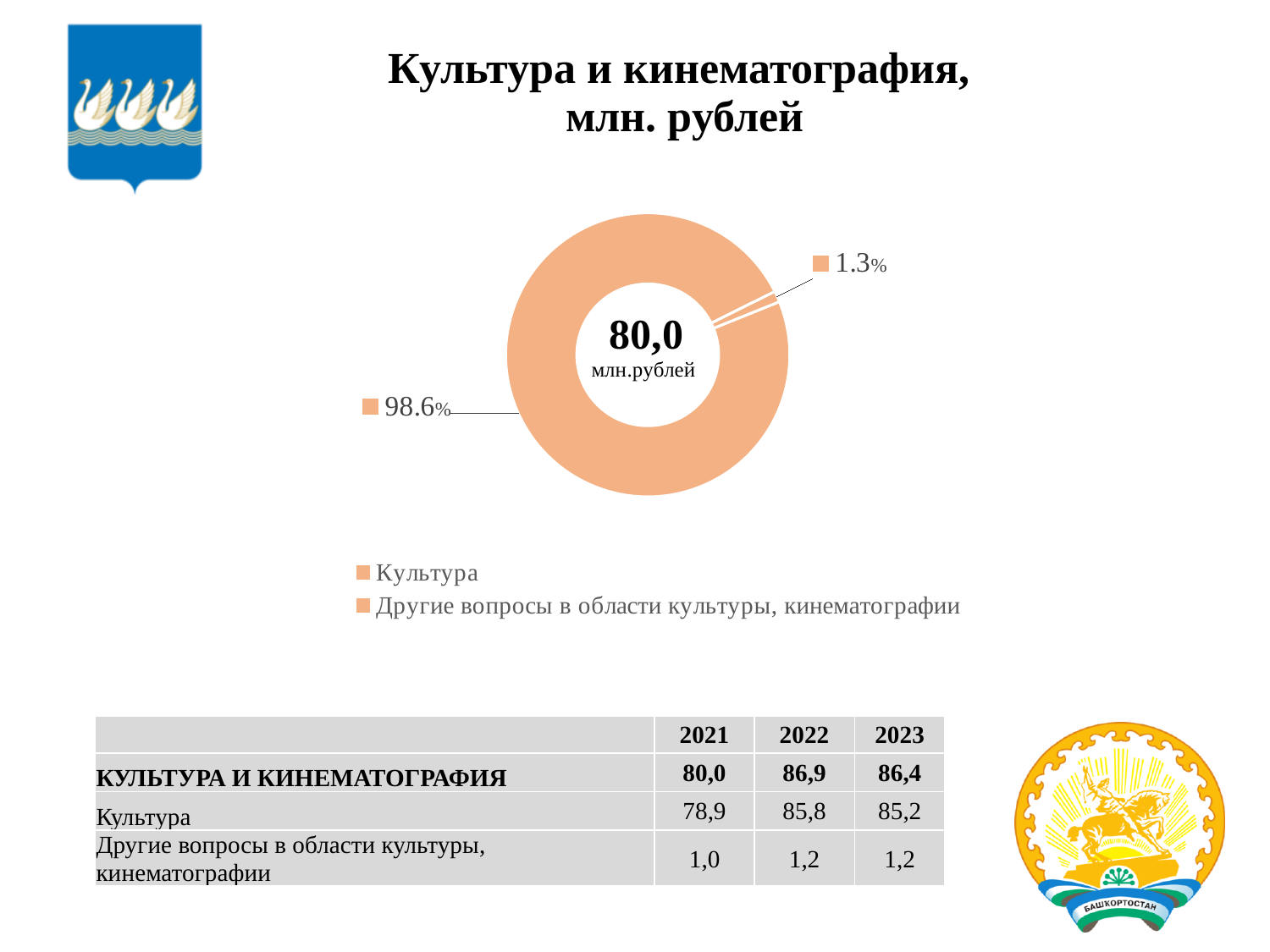
What is the title of the chart on the slide? Культура и кинематография, млн. рублей Is the share of 'Культура' in the doughnut chart greater or less than 50%? greater What total value is printed in the centre of the doughnut chart? 80,0 млн.рублей How many entries does the legend of the doughnut chart list? 2 Which slice of the doughnut chart is the largest? Культура What kind of chart is shown on the slide? Doughnut (pie) chart What percentage share does the 'Другие вопросы в области культуры, кинематографии' slice have in the doughnut chart? 1.3% Which slice of the doughnut chart is the smallest? Другие вопросы в области культуры, кинематографии What is the difference in percentage points between the two slices of the doughnut chart? 97.3 How many slices does the doughnut chart have? 2 What percentage share does the 'Культура' slice have in the doughnut chart? 98.6% Which is larger in the doughnut chart: the share of 'Культура' or the share of 'Другие вопросы в области культуры, кинематографии'? Культура